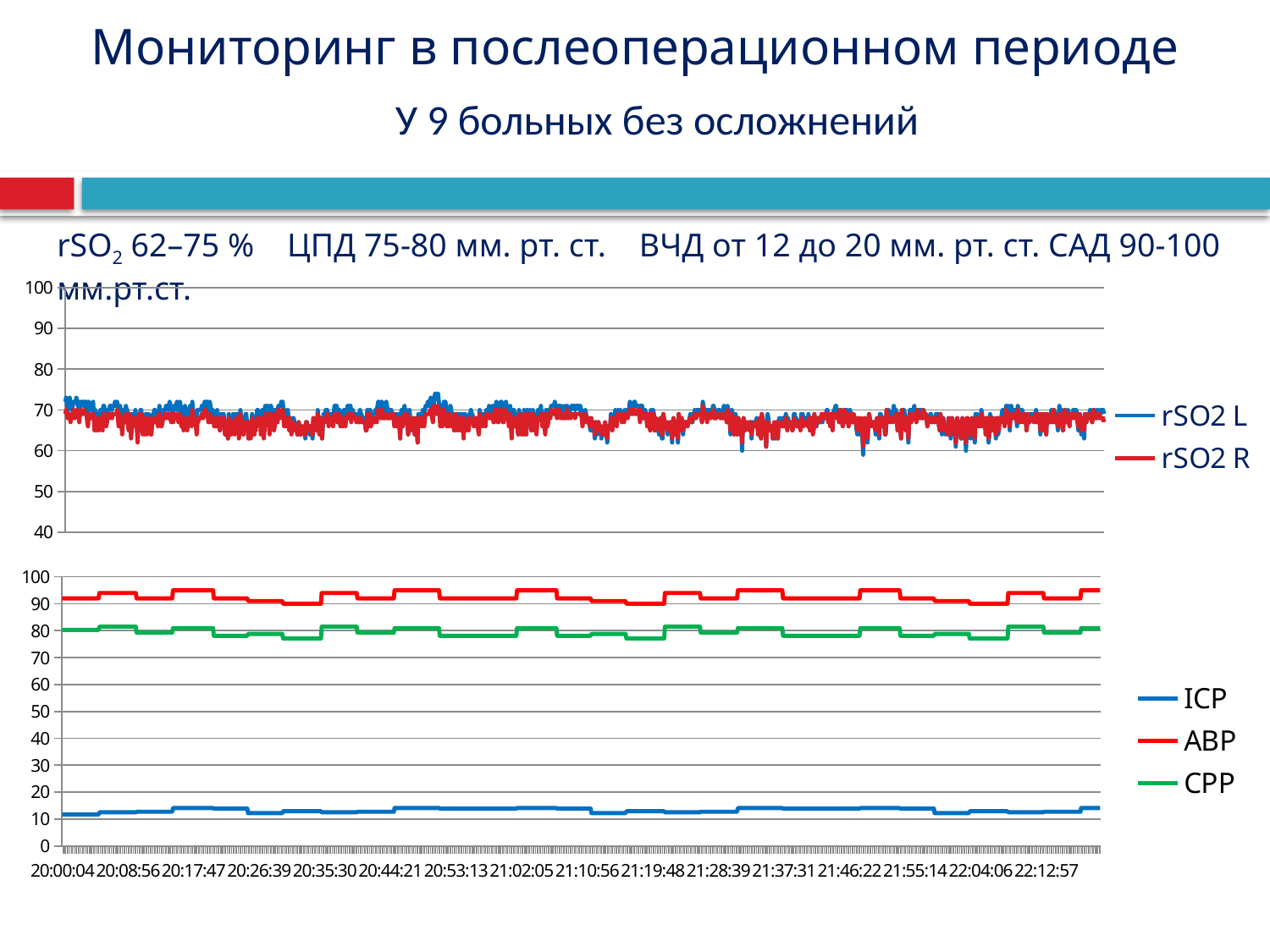
In the bottom chart, is the value of CPP greater or less than 70 throughout the recording? greater In the top chart, what colour is the line for rSO2 R? red In the bottom chart, is the value of ABP greater or less than 80 throughout the recording? greater What kind of chart is the top chart on the slide? line chart What kind of chart is the bottom chart on the slide? line chart In the top chart, is the value of rSO2 L at the start of the recording greater or less than 60? greater In the bottom chart, which series is larger, ABP or CPP? ABP In the bottom chart, which series has the lowest values throughout the recording? ICP How many series does the legend of the bottom chart list? 3 In the bottom chart, which series has the highest values throughout the recording? ABP How many series does the legend of the top chart list? 2